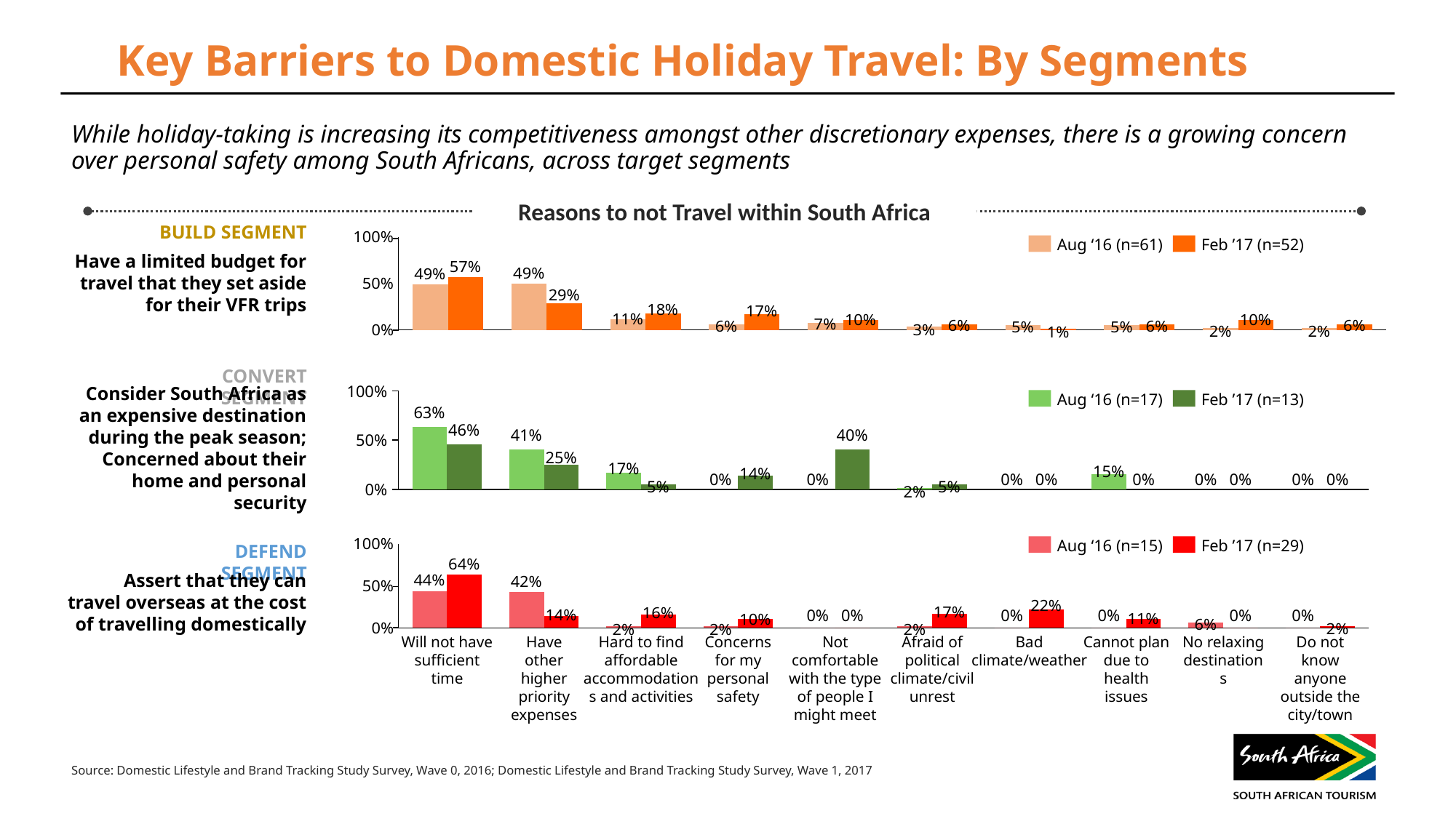
In the Defend Segment chart (bottom), which category has the highest Feb '17 value? Will not have sufficient time How many series does the legend of the Defend Segment chart (bottom) list? 2 In the Convert Segment chart (middle), which is larger for 'Have other higher priority expenses': the Aug '16 value or the Feb '17 value? Aug '16 In the Convert Segment chart (middle), what is the Feb '17 value for 'Not comfortable with the type of people I might meet'? 40% In the Defend Segment chart (bottom), what is the Aug '16 value for 'Have other higher priority expenses'? 42% In the Build Segment chart (top), what is the Feb '17 value for 'Will not have sufficient time'? 57% In the Build Segment chart (top), what is the difference between the Feb '17 and Aug '16 values for 'Concerns for my personal safety'? 11 percentage points What type of chart is used for the Convert Segment (middle) data? Bar chart How many reason categories are shown on the x axis of the charts? 10 In the Convert Segment chart (middle), which category has the highest Aug '16 value? Will not have sufficient time In the Build Segment chart (top), is the Feb '17 value for 'Will not have sufficient time' greater or less than 50%? greater In the Defend Segment chart (bottom), what is the difference between the Feb '17 and Aug '16 values for 'Will not have sufficient time'? 20 percentage points